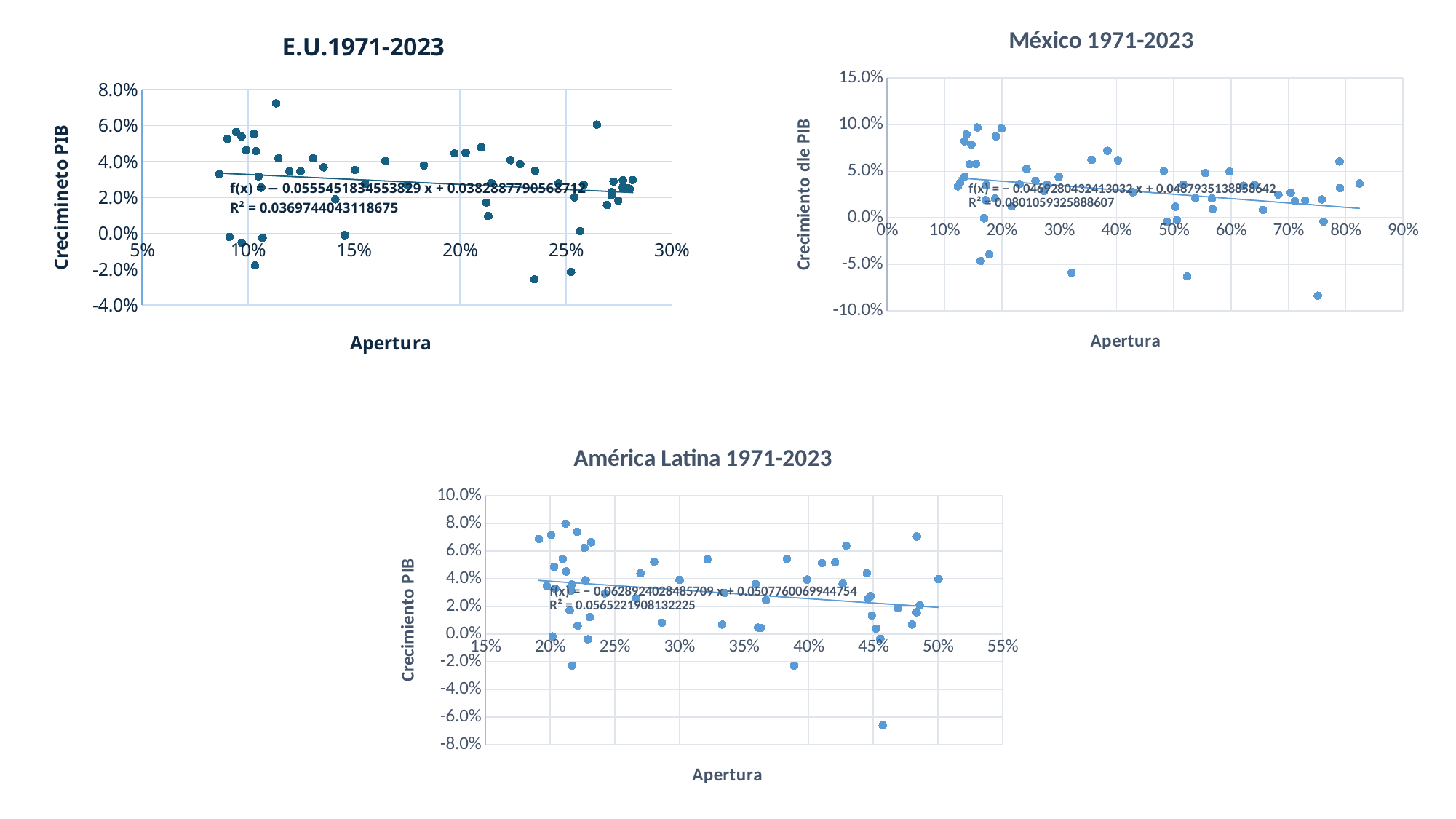
What kind of chart is 'E.U.1971-2023'? Scatter chart In the 'E.U.1971-2023' chart, is the highest plotted Crecimiento PIB value greater or less than 6.0%? greater In the 'E.U.1971-2023' chart, does the fitted trendline rise or fall as Apertura increases? Fall In the 'América Latina 1971-2023' chart, does the fitted trendline rise or fall as Apertura increases? Fall How many charts are shown on the slide? 3 What is the R² value printed on the 'México 1971-2023' chart? 0.0801059325888607 What is the R² value printed on the 'América Latina 1971-2023' chart? 0.0565221908132225 Which of the three charts shows the highest R² value? México 1971-2023 In the 'México 1971-2023' chart, is the lowest plotted value greater or less than -5.0%? less What is the x-axis label on the 'América Latina 1971-2023' chart? Apertura In the 'México 1971-2023' chart, does the fitted trendline rise or fall as Apertura increases? Fall What is the R² value printed on the 'E.U.1971-2023' chart? 0.0369744043118675